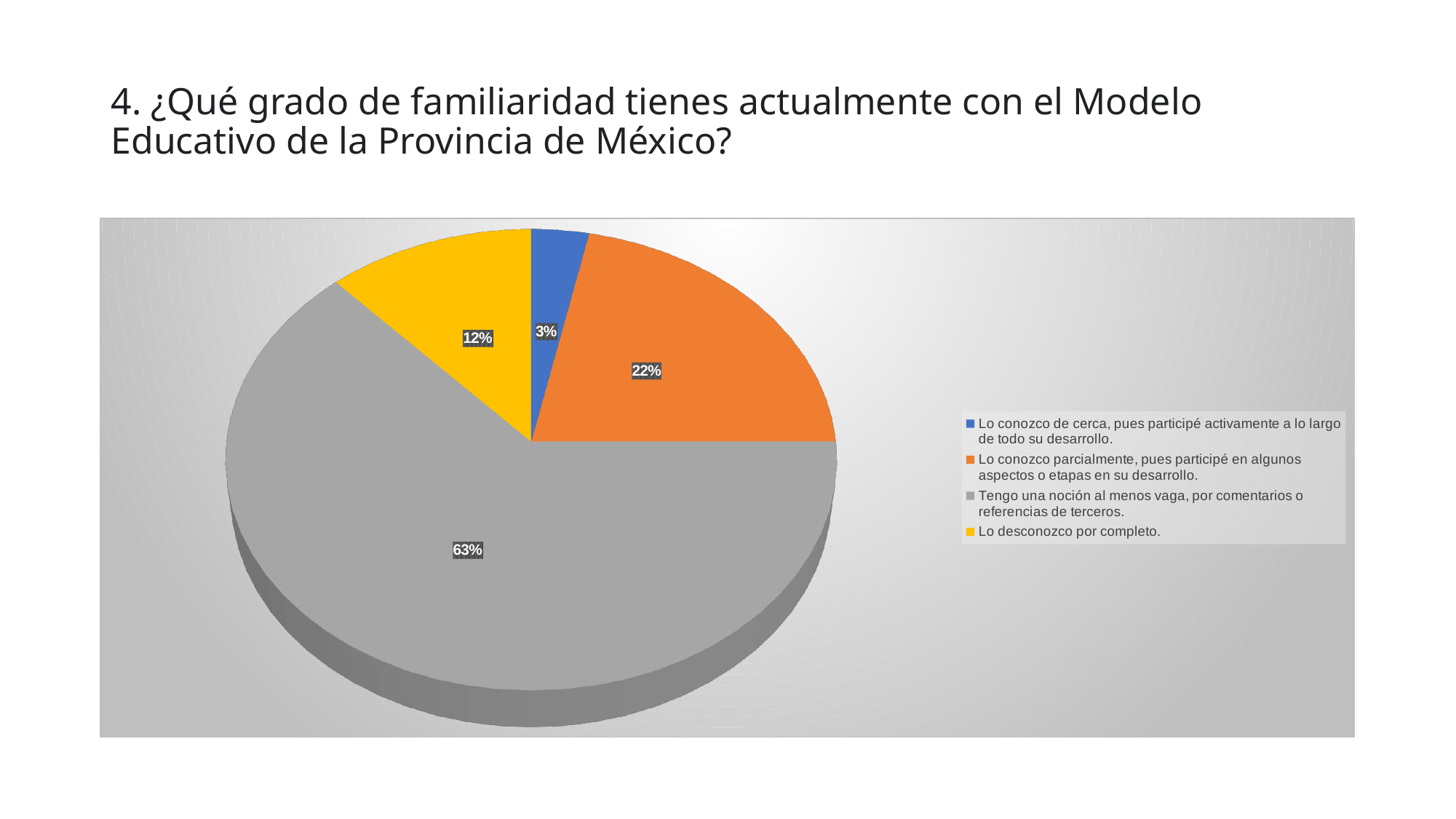
How many slices does the pie chart have? 4 What colour is the slice for "Lo desconozco por completo."? yellow Which is larger: the share for "Lo desconozco por completo." or the share for "Lo conozco de cerca"? Lo desconozco por completo. What percentage of respondents answered "Lo conozco parcialmente, pues participé en algunos aspectos o etapas en su desarrollo."? 22% What percentage of respondents answered "Lo desconozco por completo."? 12% What percentage of respondents answered "Tengo una noción al menos vaga, por comentarios o referencias de terceros."? 63% What is the difference in percentage points between the "Tengo una noción al menos vaga" slice and the "Lo conozco parcialmente" slice? 41 Which response has the smallest share of the pie? Lo conozco de cerca, pues participé activamente a lo largo de todo su desarrollo. How many entries does the legend list? 4 Which response has the largest share of the pie? Tengo una noción al menos vaga, por comentarios o referencias de terceros. What percentage of respondents answered "Lo conozco de cerca, pues participé activamente a lo largo de todo su desarrollo."? 3% What kind of chart is shown on the slide? pie chart